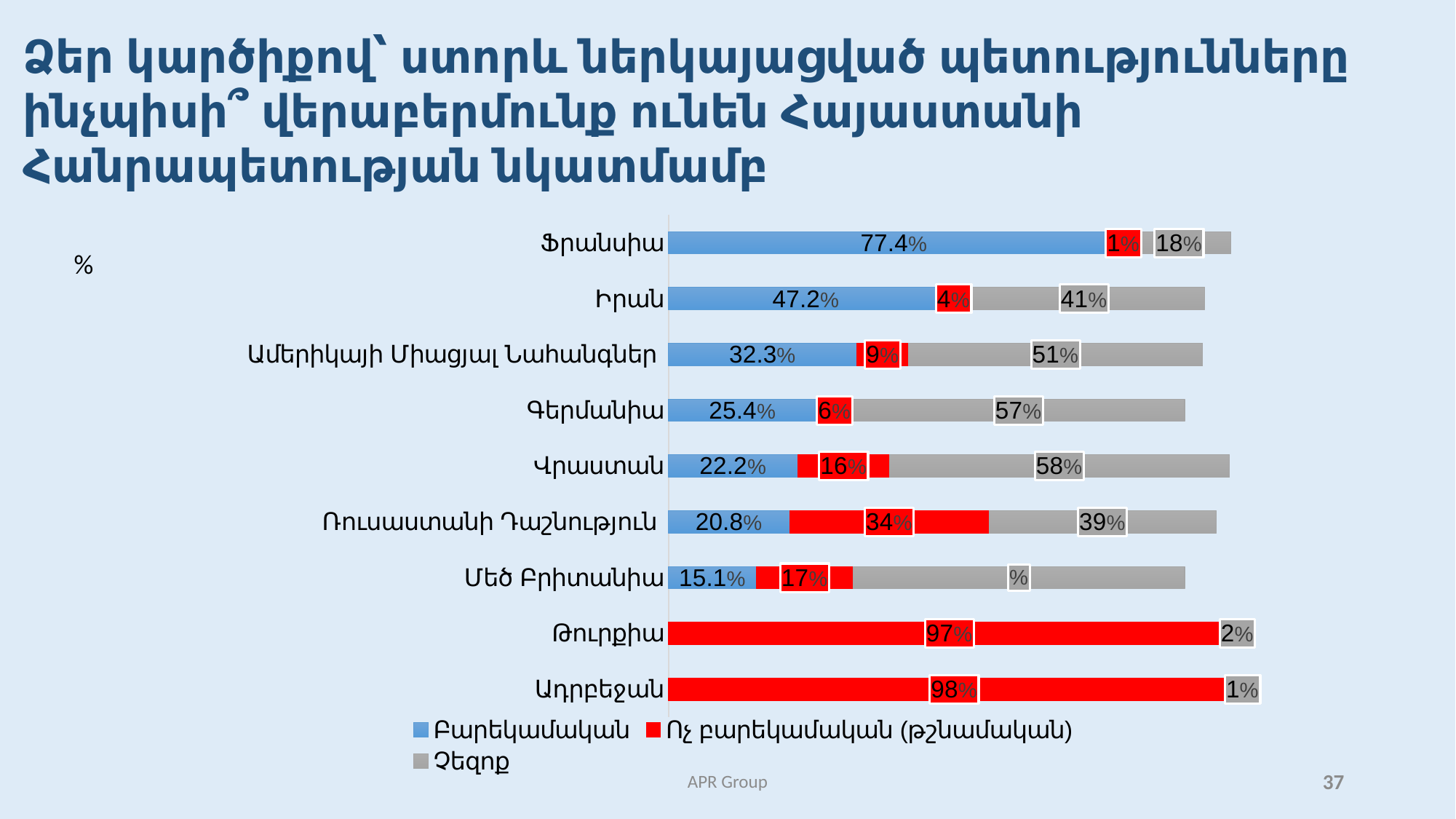
Which is larger, the Չեզոք value for Գերմանիա or for Վրաստան? Վրաստան Which country has the lowest Ոչ բարեկամական (թշնամական) value? Ֆրանսիա What type of chart is shown on the slide? Stacked bar chart Which colour represents the Չեզոք series in the chart? Grey What is the Չեզոք value for Իրան? 41% How many series does the legend list? 3 Which country has the highest Բարեկամական value? Ֆրանսիա What is the Բարեկամական value for Ֆրանսիա? 77.4% What is the Ոչ բարեկամական (թշնամական) value for Ադրբեջան? 98% How many countries are shown on the chart? 9 What is the Ոչ բարեկամական (թշնամական) value for Ռուսաստանի Դաշնություն? 34% What is the difference between the Բարեկամական values for Ֆրանսիա and Իրան? 30.2%